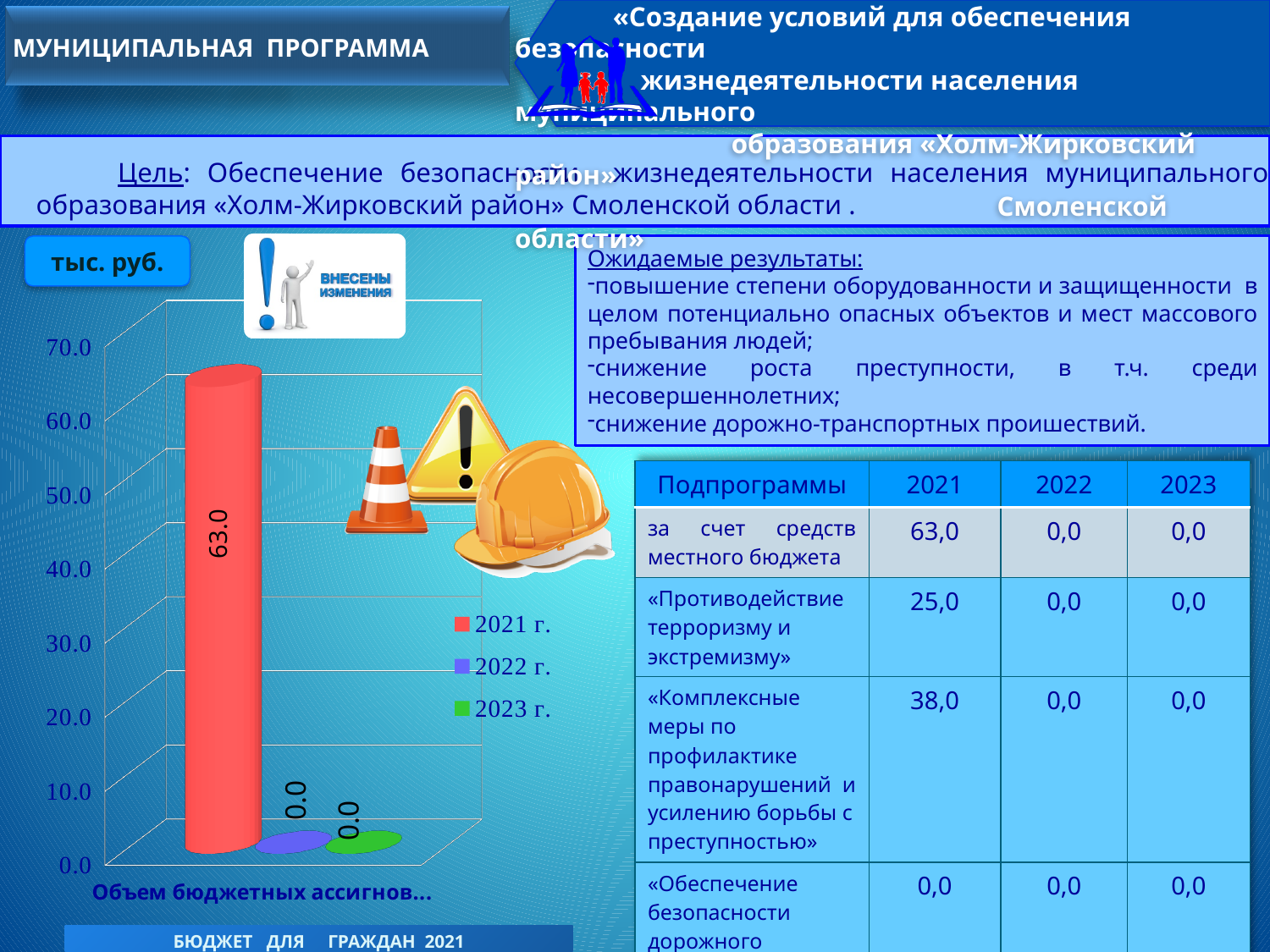
What kind of chart is shown on the slide? bar chart What is the value for 2023 г. in the chart? 0.0 What is the difference between the values for 2021 г. and 2022 г.? 63.0 Which is larger, the value for 2021 г. or the value for 2023 г.? 2021 г. What is the value for 2022 г. in the chart? 0.0 What is the highest tick value shown on the vertical axis of the chart? 70.0 Do the values fall or rise from 2021 г. to 2023 г. in the chart? fall Is the value for 2021 г. greater or less than 60.0? greater How many series does the chart legend list? 3 What colour is the bar for 2021 г. in the chart? red Which year has the highest value in the chart? 2021 г. What is the value for 2021 г. in the chart? 63.0